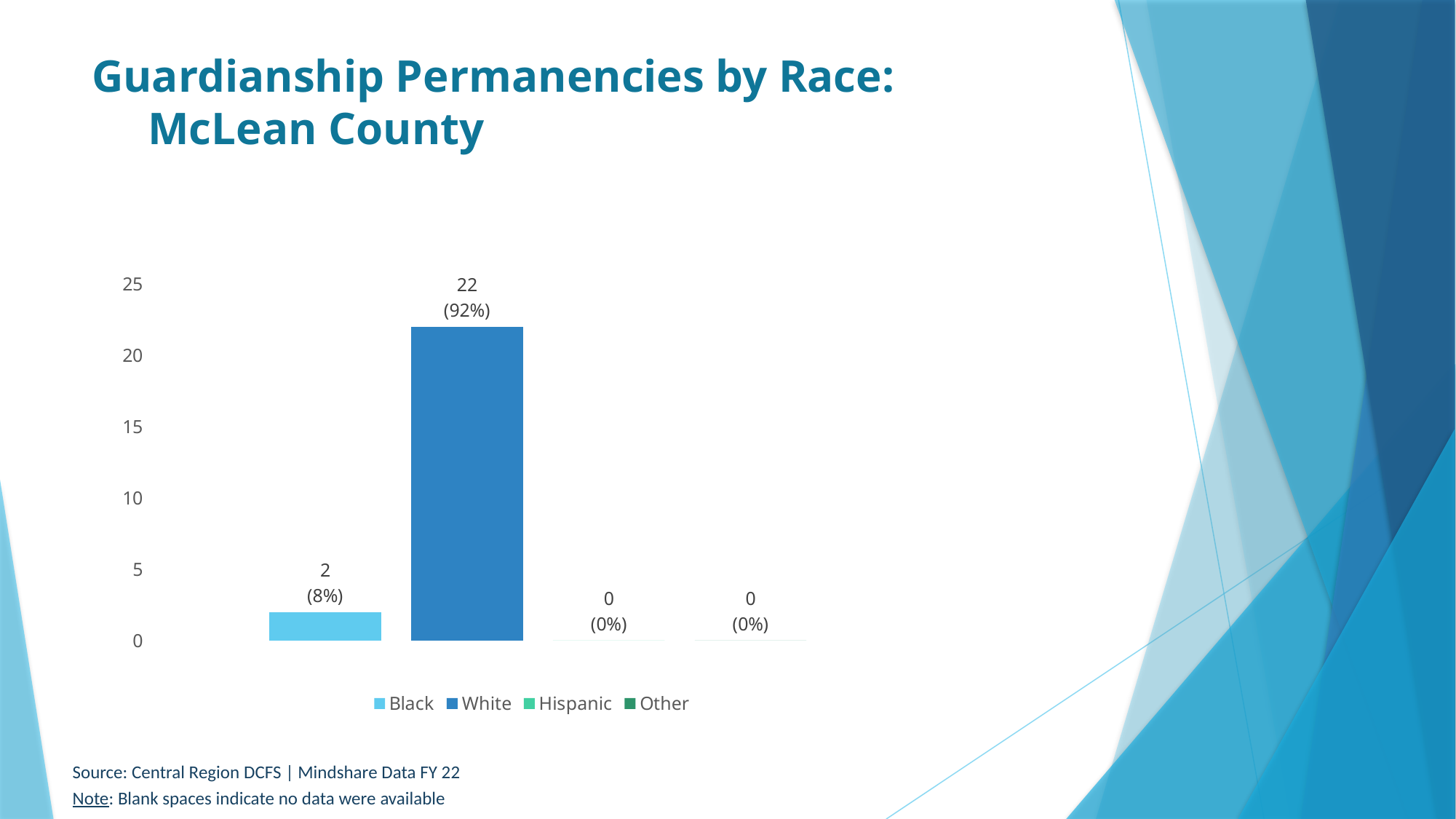
What is the difference between the White and Black values? 20 What is the number of guardianship permanencies for White children in McLean County? 22 Is the value for White greater or less than 20? greater How many race categories does the legend list? 4 What percentage of guardianship permanencies is shown for White? 92% What is the title of the slide? Guardianship Permanencies by Race: McLean County What percentage of guardianship permanencies is shown for Black? 8% What kind of chart is shown on the slide? Bar chart What value is shown for Hispanic? 0 What is the number of guardianship permanencies for Black children in McLean County? 2 Which is larger, the value for Black or the value for White? White Which race category has the highest number of guardianship permanencies? White